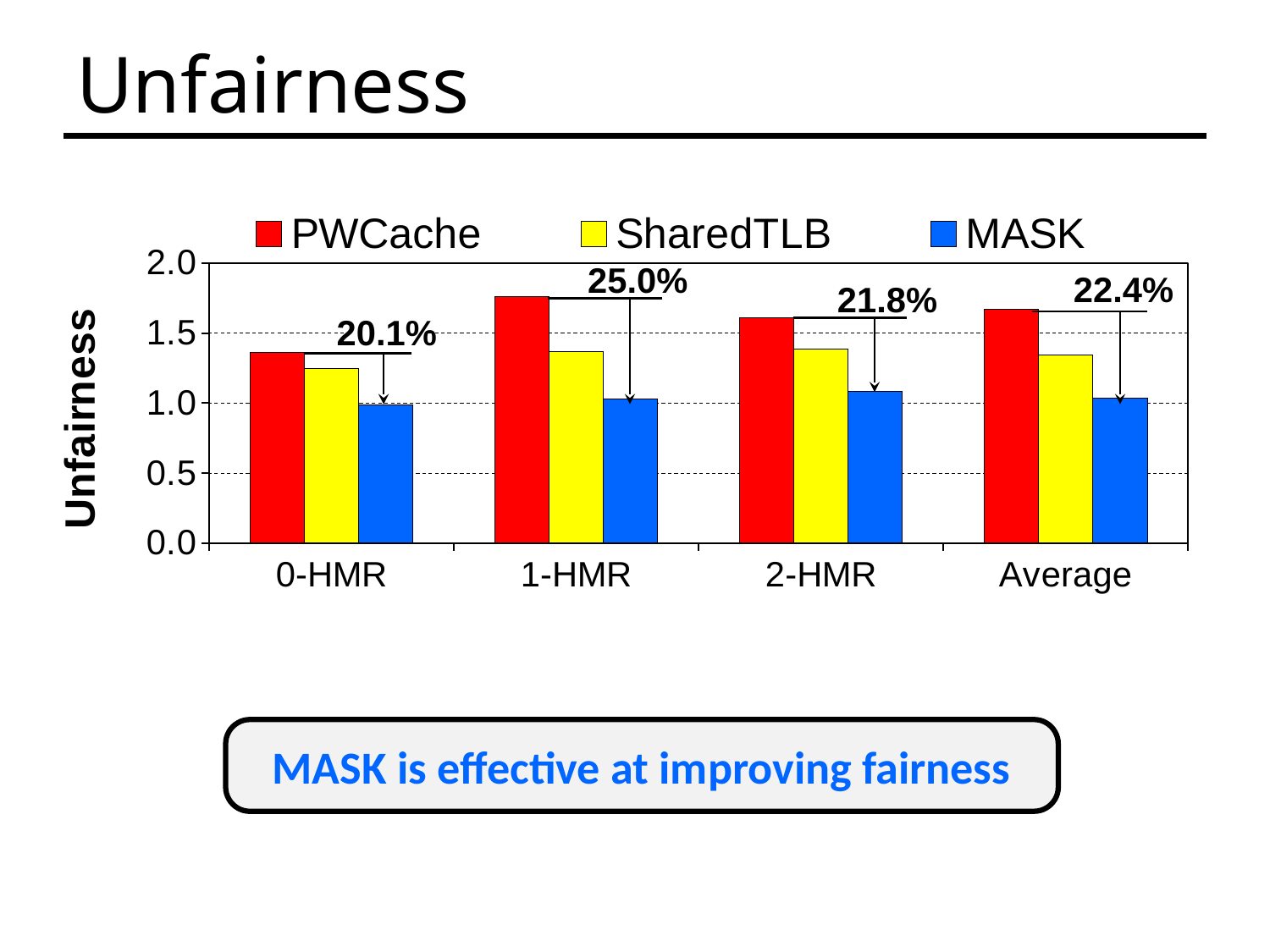
What is the label on the y axis? Unfairness Within the 0-HMR category, which series has the lowest bar? MASK Is the PWCache value for 1-HMR greater or less than 1.5? greater How many categories are shown on the x axis? 4 For 2-HMR, which is larger: the PWCache value or the MASK value? PWCache What kind of chart is shown on the slide? bar chart Which series is shown in blue in the legend? MASK For which category is the PWCache bar the highest? 1-HMR How many series does the legend list? 3 What percentage improvement is annotated above the Average category? 22.4% Is the PWCache value for 0-HMR greater or less than 1.5? less Is the SharedTLB value for 1-HMR greater or less than 1.5? less